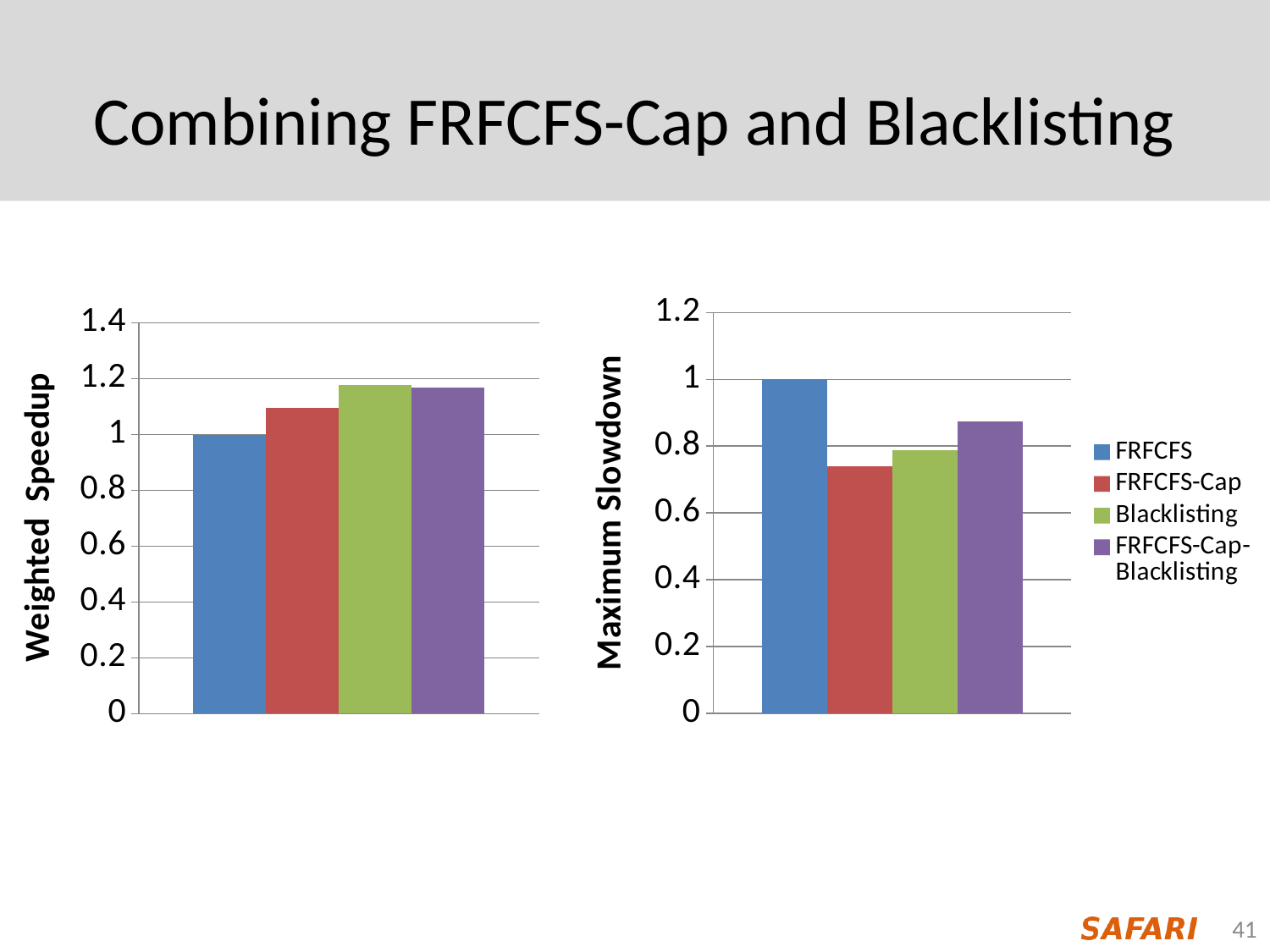
In the Weighted Speedup chart on the left, which series has the lowest value? FRFCFS In the Maximum Slowdown chart on the right, which series has the highest value? FRFCFS In the Maximum Slowdown chart on the right, what is the value for FRFCFS? 1 What kind of chart is the Weighted Speedup chart on the left? bar chart In the Maximum Slowdown chart on the right, is the value for FRFCFS-Cap-Blacklisting greater or less than 0.8? greater In the Weighted Speedup chart on the left, which is larger: FRFCFS or Blacklisting? Blacklisting In the Weighted Speedup chart on the left, is the value for FRFCFS-Cap greater or less than 1? greater In the Maximum Slowdown chart on the right, which is larger: FRFCFS-Cap or FRFCFS-Cap-Blacklisting? FRFCFS-Cap-Blacklisting What colour represents Blacklisting in the legend? green In the Weighted Speedup chart on the left, what is the value for FRFCFS? 1 In the Maximum Slowdown chart on the right, is the value for FRFCFS-Cap greater or less than 0.8? less How many series does the legend list? 4